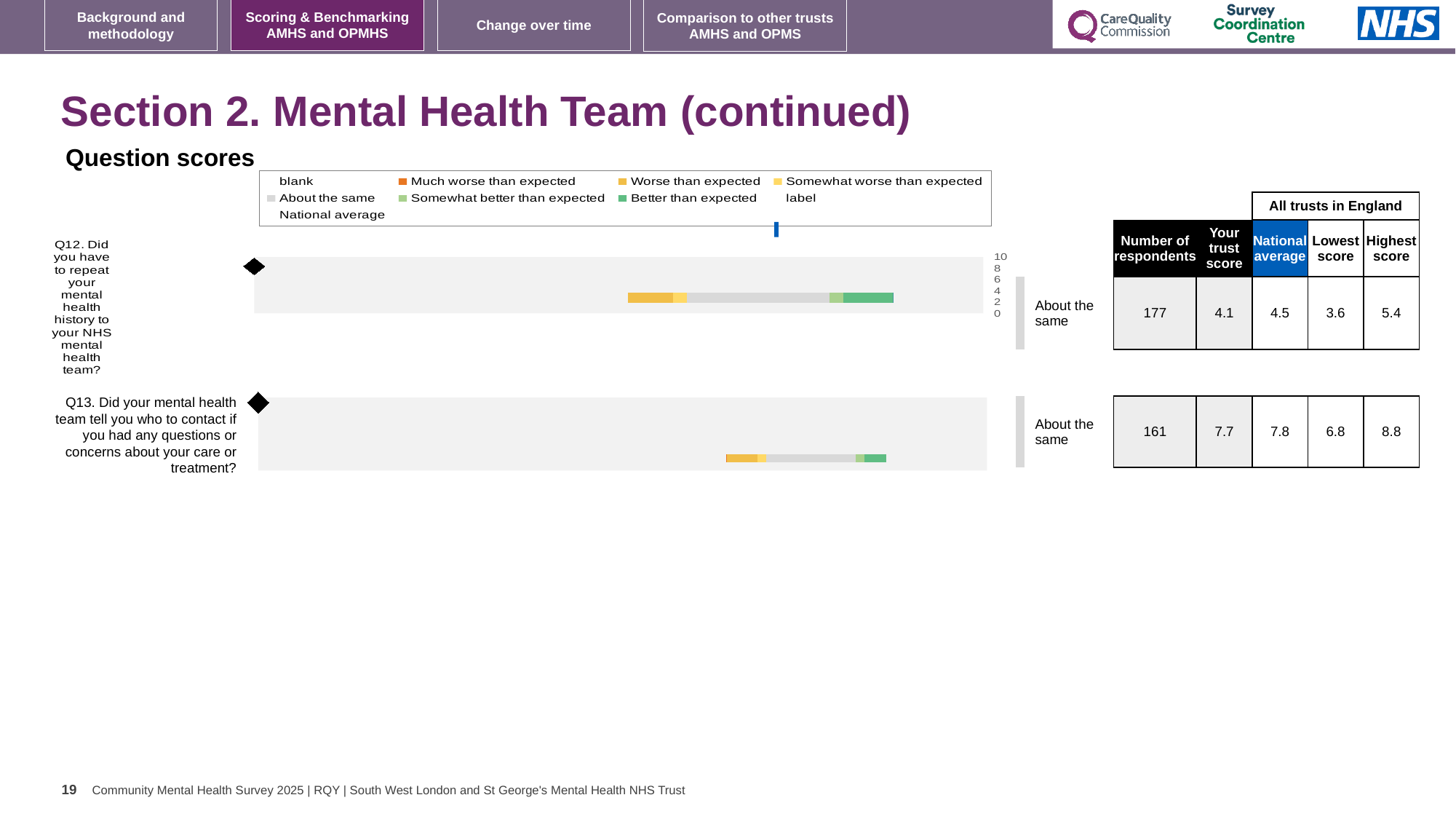
What kind of chart is used to show the question scores for Q12 and Q13? bar chart What is the maximum value shown on the score axis of the chart? 10 What is the highest score among all trusts in England for Q13? 8.8 Is the trust score for Q12 larger or smaller than the national average for Q12? smaller What is the national average for Q12? 4.5 What is the trust score for Q13? 7.7 How many survey questions are plotted on the slide? 2 What benchmark category label is shown next to the Q13 bar? About the same What is the difference between the highest score and the lowest score for Q12? 1.8 What is the number of respondents for Q12? 177 Which question has more respondents, Q12 or Q13? Q12 What benchmark category label is shown next to the Q12 bar? About the same